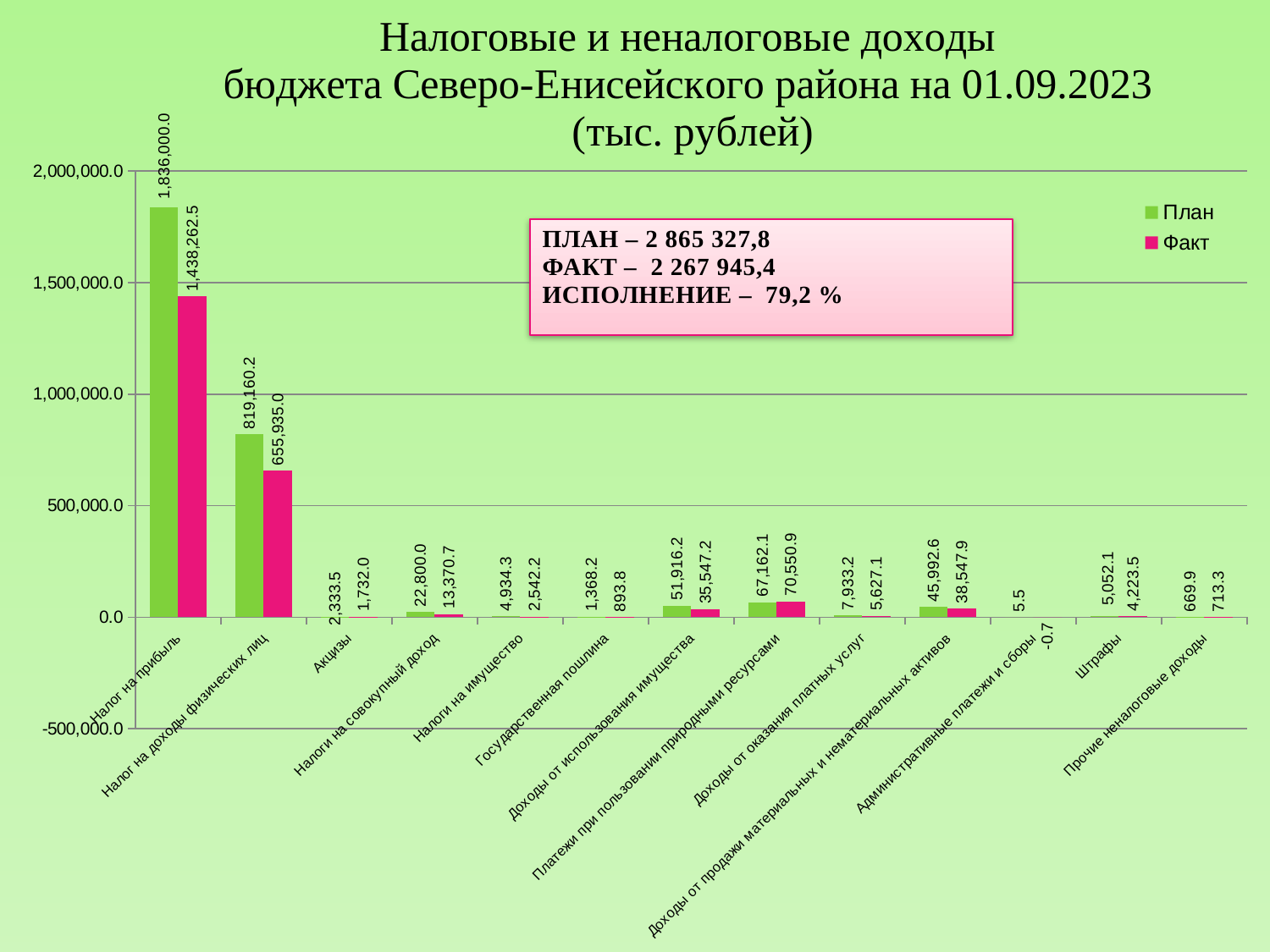
Which category has the lowest Факт value? Административные платежи и сборы What is the Факт value for Платежи при пользовании природными ресурсами? 70,550.9 What is the Факт value for Налог на доходы физических лиц? 655,935.0 For Платежи при пользовании природными ресурсами, which is larger: План or Факт? Факт What is the План value for Налог на прибыль? 1,836,000.0 Is the План value for Налог на доходы физических лиц greater or less than 1,000,000.0? less How many categories are shown on the x axis? 13 Which category has the highest План value? Налог на прибыль What kind of chart is shown on the slide? bar chart What is the difference between the План and Факт values for Налог на прибыль? 397,737.5 How many series does the legend list? 2 What is the Факт value for Акцизы? 1,732.0